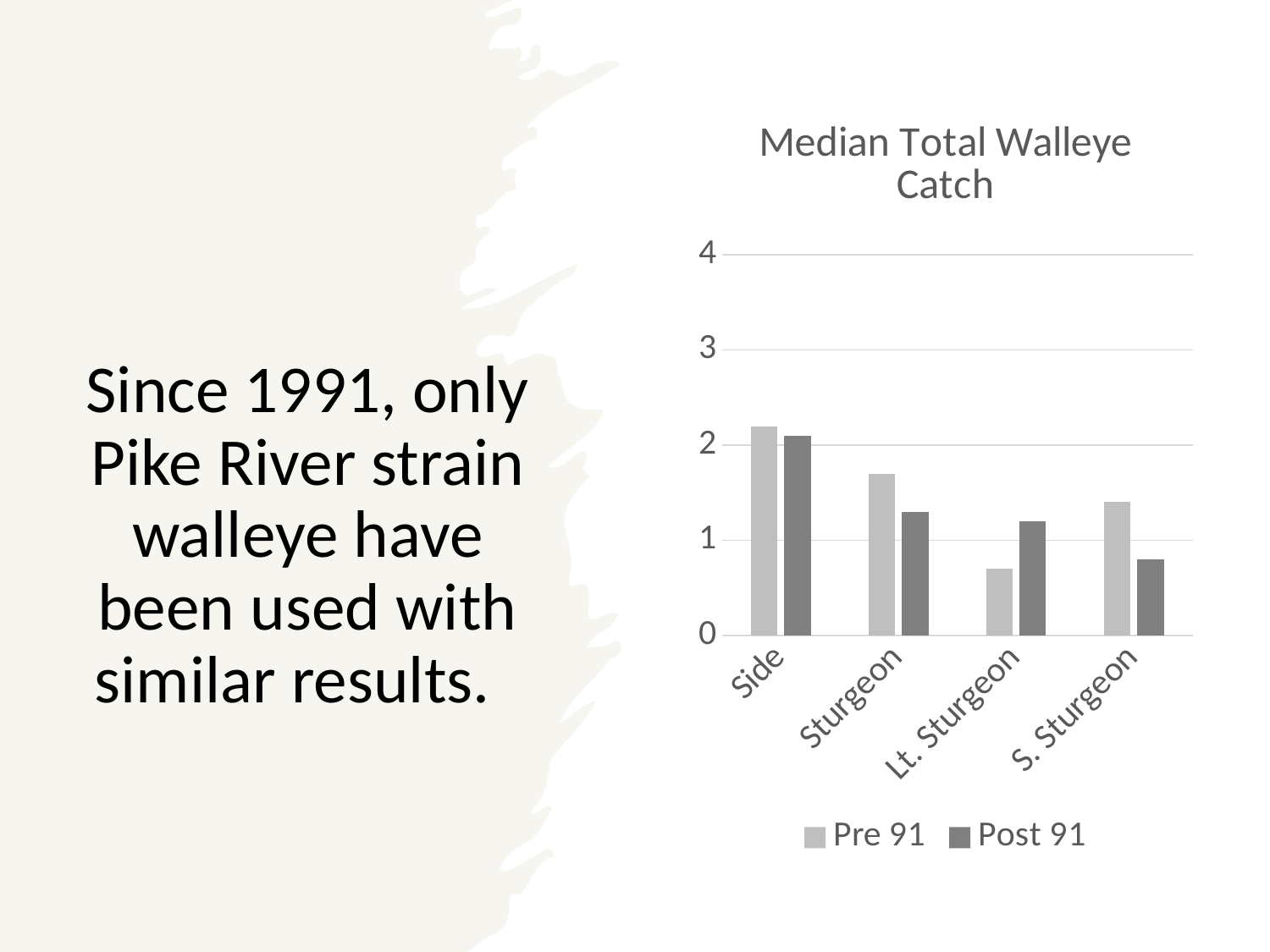
Which category has the highest Pre 91 value? Side Which series is shown in the darker grey bars? Post 91 Which category has the lowest Pre 91 value? Lt. Sturgeon Is the Pre 91 value for Lt. Sturgeon greater or less than 1? less How many series does the legend list? 2 For Lt. Sturgeon, which is larger: the Pre 91 value or the Post 91 value? Post 91 How many categories are shown on the x axis? 4 Is the Pre 91 value for Side greater or less than 2? greater For Sturgeon, which is larger: the Pre 91 value or the Post 91 value? Pre 91 Which category has the lowest Post 91 value? S. Sturgeon What kind of chart is shown on the slide? Bar chart What is the title of the chart? Median Total Walleye Catch